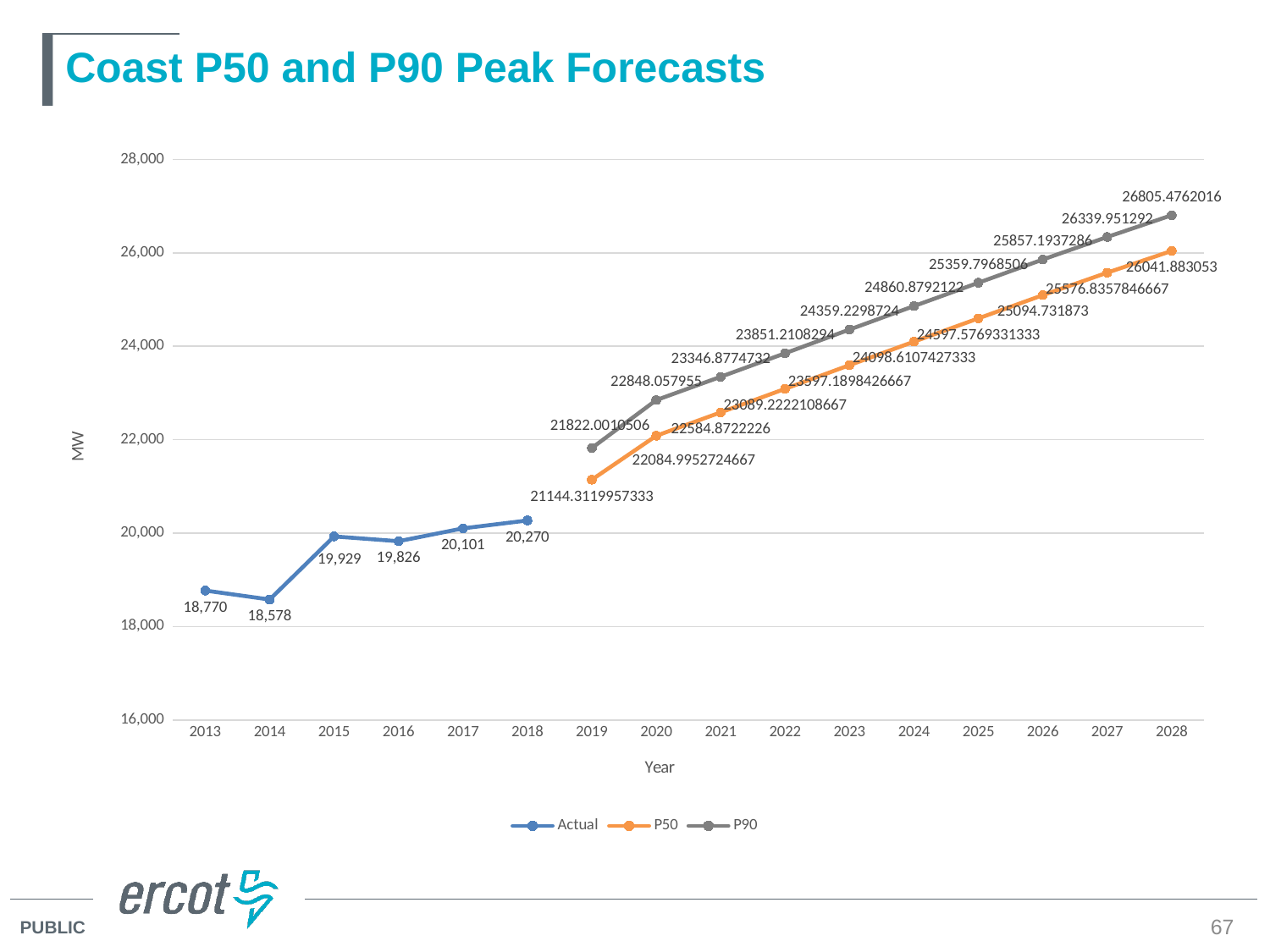
How many years are shown on the x axis? 16 What is the P50 value for 2028? 26041.883053 Is the P50 value for 2019 greater or less than 22,000? less What is the Actual value for 2018? 20,270 What is the Actual value for 2013? 18,770 What is the P90 value for 2028? 26805.4762016 What is the difference between the Actual values for 2018 and 2013? 1,500 In which year is the Actual series lowest? 2014 How many series does the legend list? 3 What kind of chart is shown on the slide? line chart Which year has the larger Actual value, 2015 or 2016? 2015 Does the P90 series rise or fall from 2019 to 2028? rise